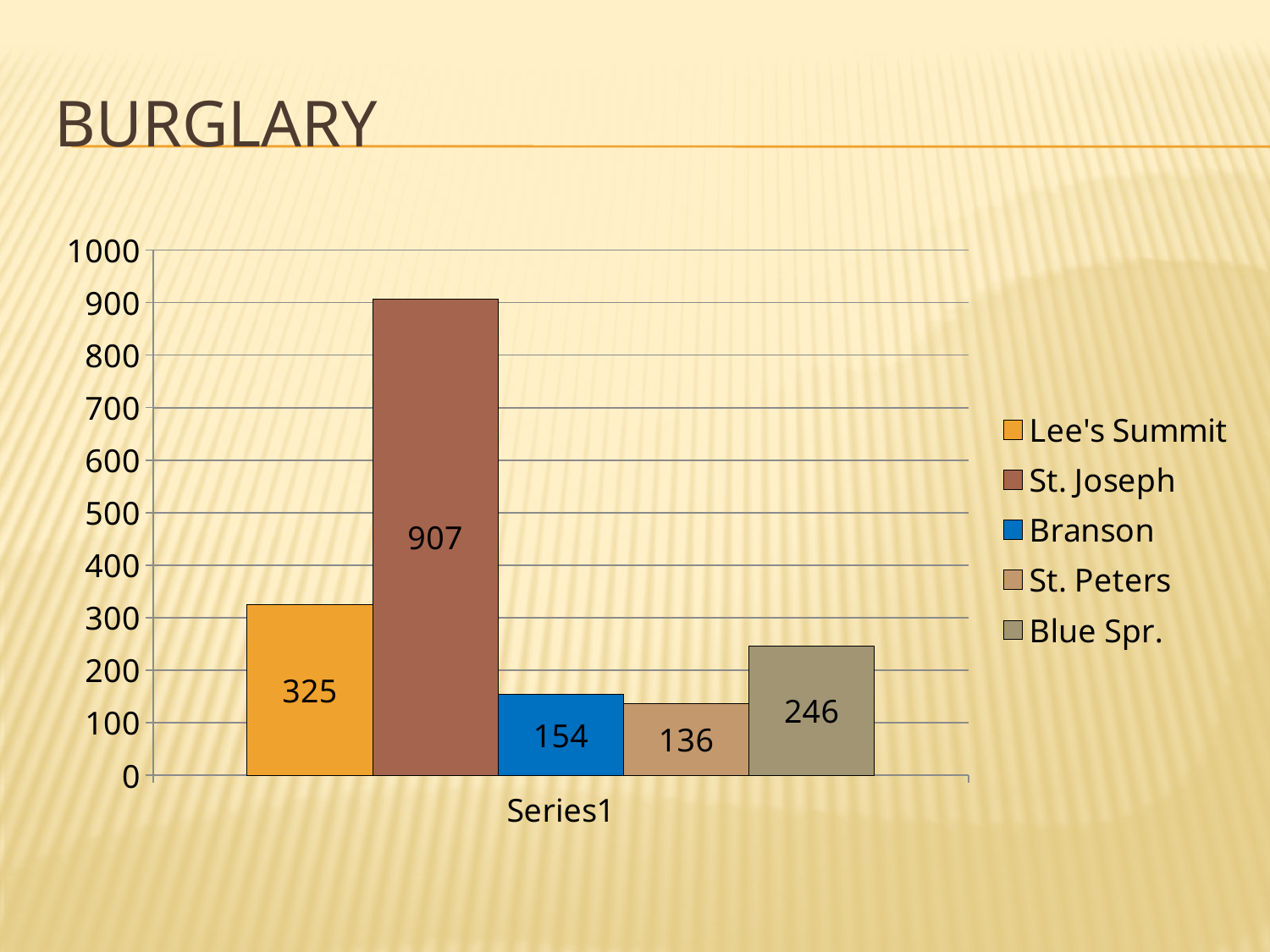
What is the burglary value for Branson? 154 Which has a larger burglary value, Lee's Summit or Blue Spr.? Lee's Summit Which city has the lowest burglary value? St. Peters What is the burglary value for Lee's Summit? 325 What kind of chart is shown on the slide? Bar chart What is the difference between the burglary values for St. Joseph and Lee's Summit? 582 What is the title of the slide? BURGLARY What is the difference between the burglary values for Blue Spr. and St. Peters? 110 Which city has the highest burglary value? St. Joseph What is the burglary value for St. Joseph? 907 What is the burglary value for Blue Spr.? 246 How many cities are shown in the legend? 5